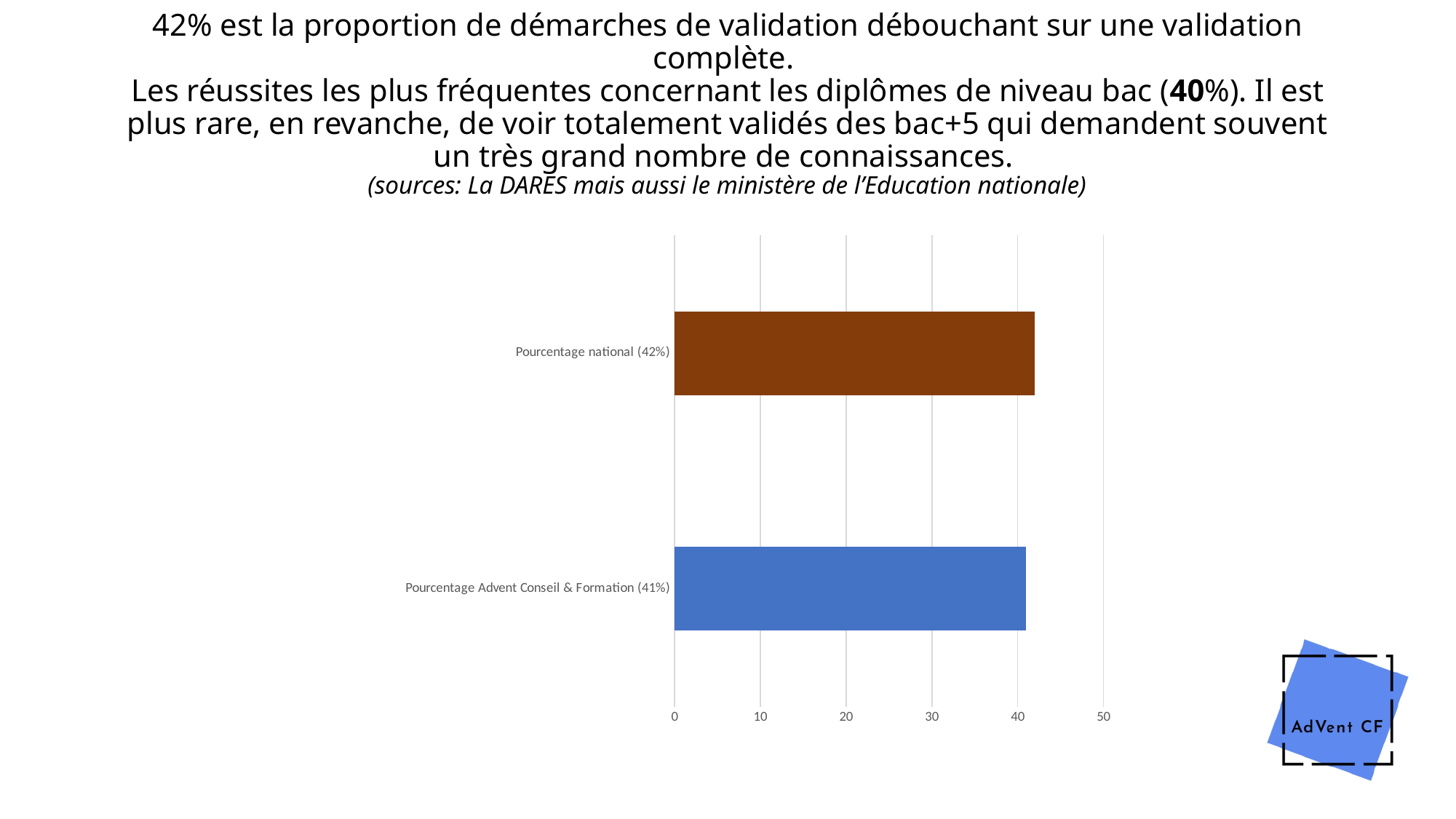
What is the value for Pourcentage national? 42% Which category has the higher value? Pourcentage national (42%) What colour is the bar for Pourcentage national? brown How many bars does the chart show? 2 What kind of chart is shown on the slide? bar chart What is the difference between the Pourcentage national and the Pourcentage Advent Conseil & Formation values? 1% Is the value for Pourcentage national greater or less than 30? greater Which category has the lower value? Pourcentage Advent Conseil & Formation (41%) What is the highest value shown on the horizontal axis? 50 Is the value for Pourcentage Advent Conseil & Formation greater or less than 50? less What is the value for Pourcentage Advent Conseil & Formation? 41%